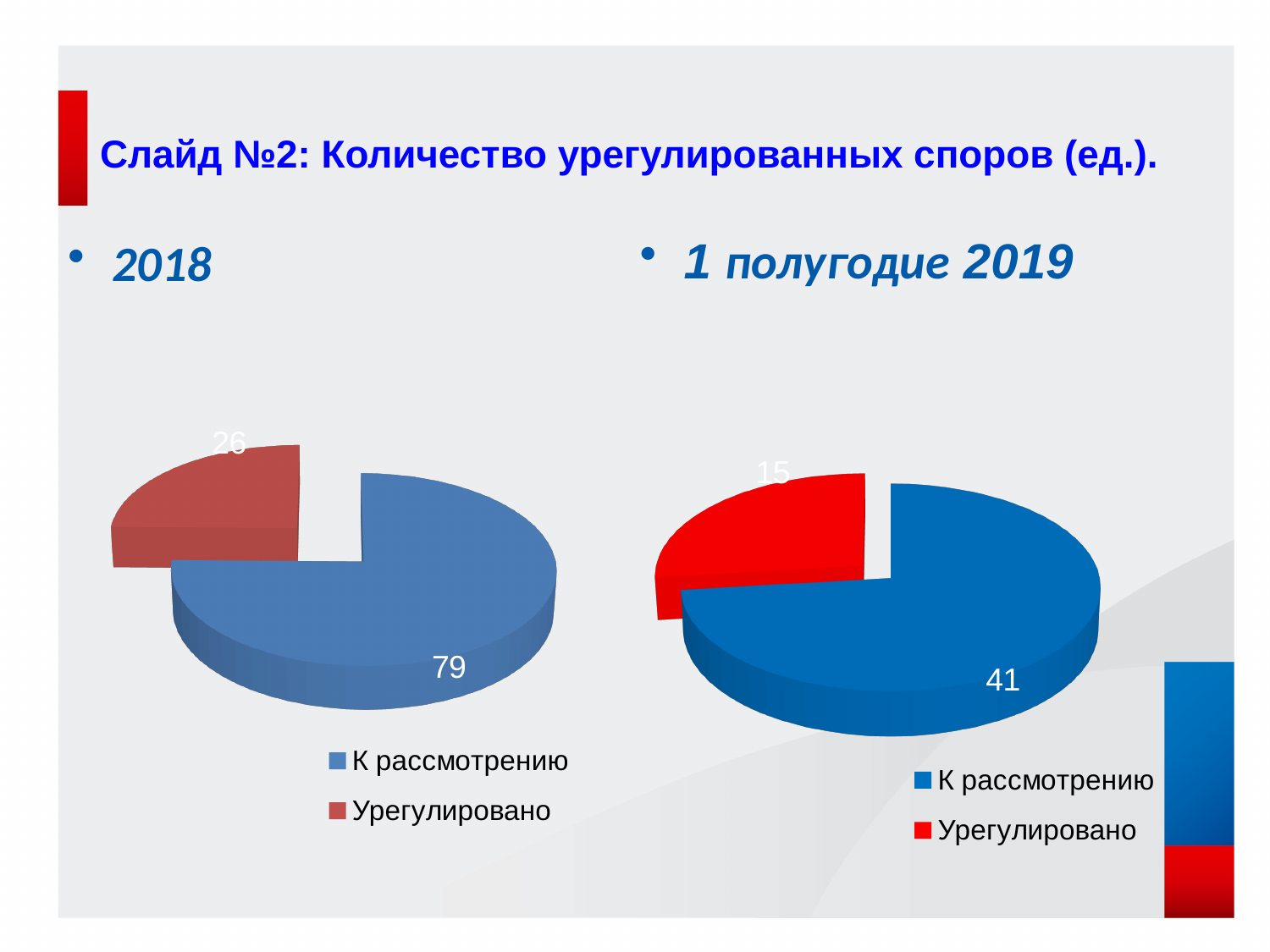
How many categories does the legend of the 1 полугодие 2019 chart list? 2 In the 1 полугодие 2019 pie chart, what is the difference between К рассмотрению and Урегулировано? 26 In the 2018 pie chart, what is the difference between К рассмотрению and Урегулировано? 53 Which is larger: Урегулировано in the 2018 chart or Урегулировано in the 1 полугодие 2019 chart? 2018 In the 2018 pie chart, which category has the largest slice? К рассмотрению In the 2018 pie chart, what is the value for Урегулировано? 26 In the 1 полугодие 2019 pie chart, what is the value for Урегулировано? 15 In the 1 полугодие 2019 pie chart, what is the value for К рассмотрению? 41 In the 2018 pie chart, what is the value for К рассмотрению? 79 What type of chart is used on the left for 2018? Pie chart In the 1 полугодие 2019 pie chart, which category has the smallest slice? Урегулировано In the 2018 pie chart, what share of the total does Урегулировано represent, to one decimal place? 24.8%